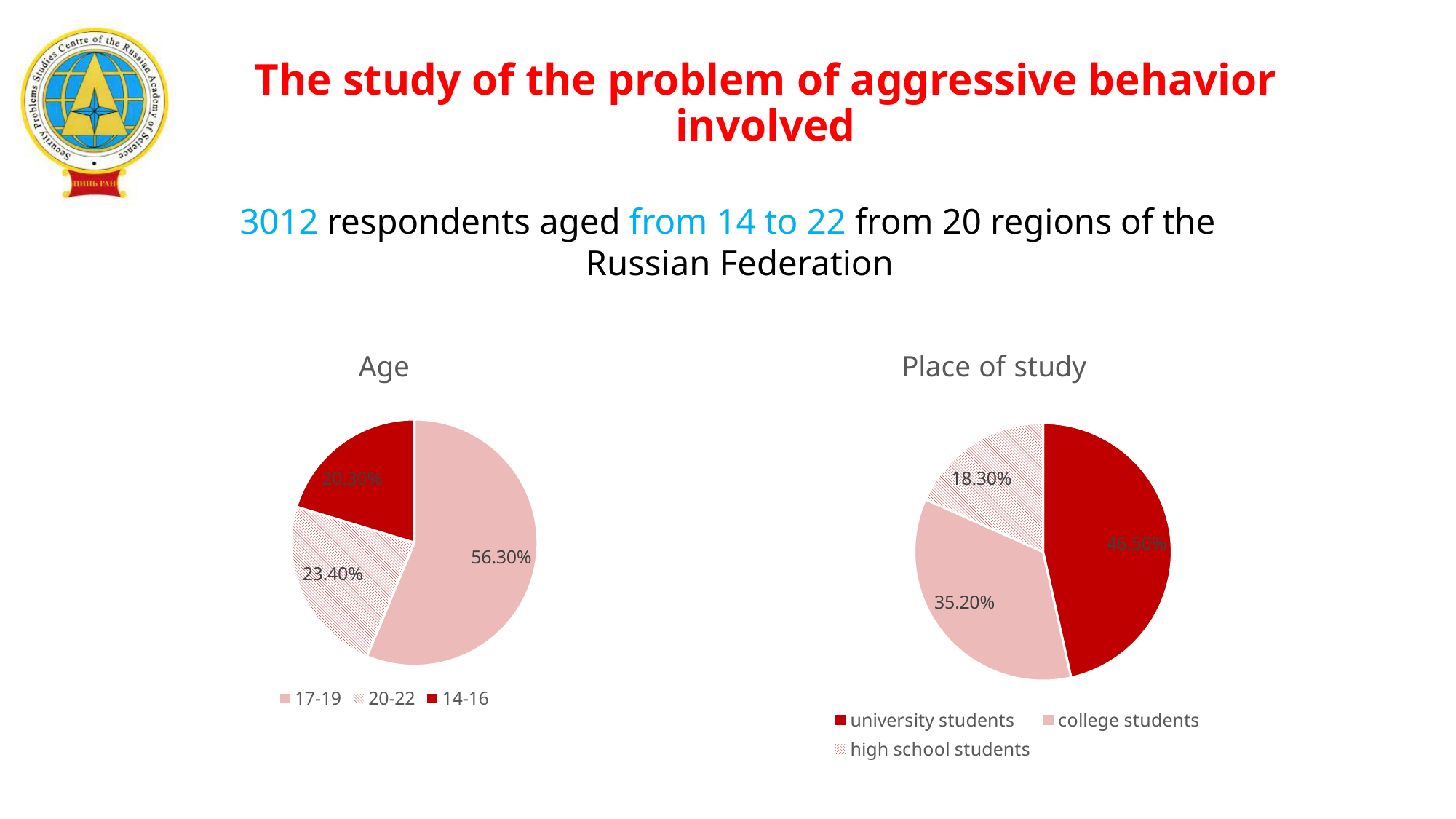
In the "Age" chart, which age group has the largest share? 17-19 What type of chart is the "Age" chart? pie chart In the "Place of study" chart, which is larger: the share of college students or the share of high school students? college students In the "Place of study" chart, what is the difference between the shares of university students and college students? 11.30% In the "Age" chart, what share of respondents are aged 17-19? 56.30% In the "Place of study" chart, what share of respondents are college students? 35.20% How many categories does the "Place of study" chart's legend list? 3 In the "Age" chart, what is the difference between the shares of the 20-22 and 14-16 groups? 3.10% In the "Place of study" chart, which group has the largest share? university students In the "Age" chart, which age group has the smallest share? 14-16 In the "Age" chart, what percentage is shown for the 14-16 age group? 20.30% In the "Place of study" chart, what percentage is shown for high school students? 18.30%